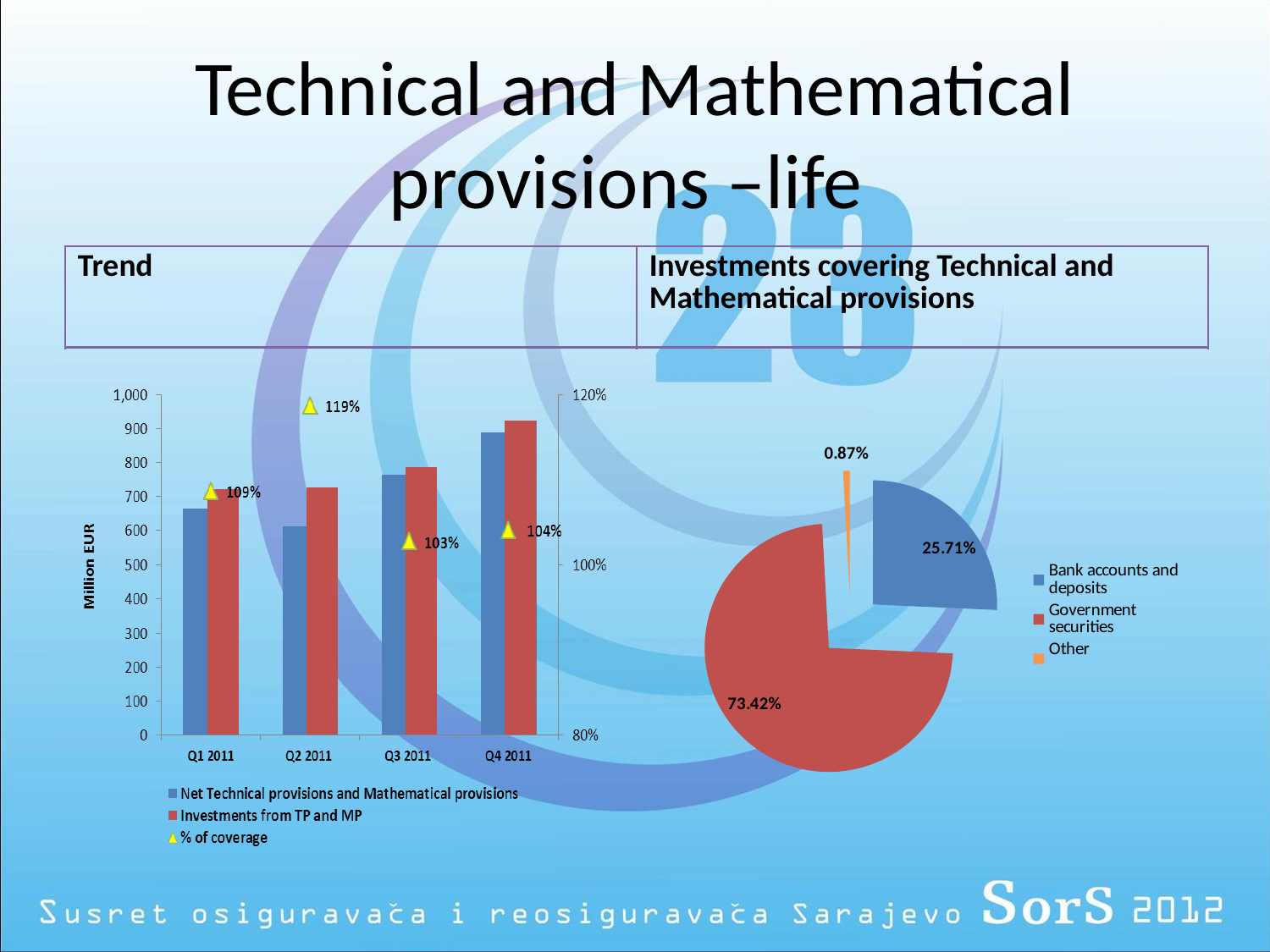
In the pie chart on the right, which category has the smallest share? Other In the Trend chart, what is the % of coverage for Q3 2011? 103% In the Trend chart, is the value of Investments from TP and MP for Q4 2011 greater or less than 900? greater In the Trend chart, is the value of Net Technical provisions and Mathematical provisions for Q1 2011 greater or less than 600? greater In the pie chart on the right, what share do Government securities have? 73.42% In the Trend chart, which quarter has the highest % of coverage? Q2 2011 In the Trend chart, what is the difference in % of coverage between Q2 2011 and Q4 2011? 15% In the Trend chart, how many series does the legend list? 3 What kind of chart is shown under the heading 'Investments covering Technical and Mathematical provisions'? Pie chart In the Trend chart, how many quarters are shown on the x axis? 4 In the Trend chart, which quarter has the lowest % of coverage? Q3 2011 In the Trend chart, what is the % of coverage for Q2 2011? 119%